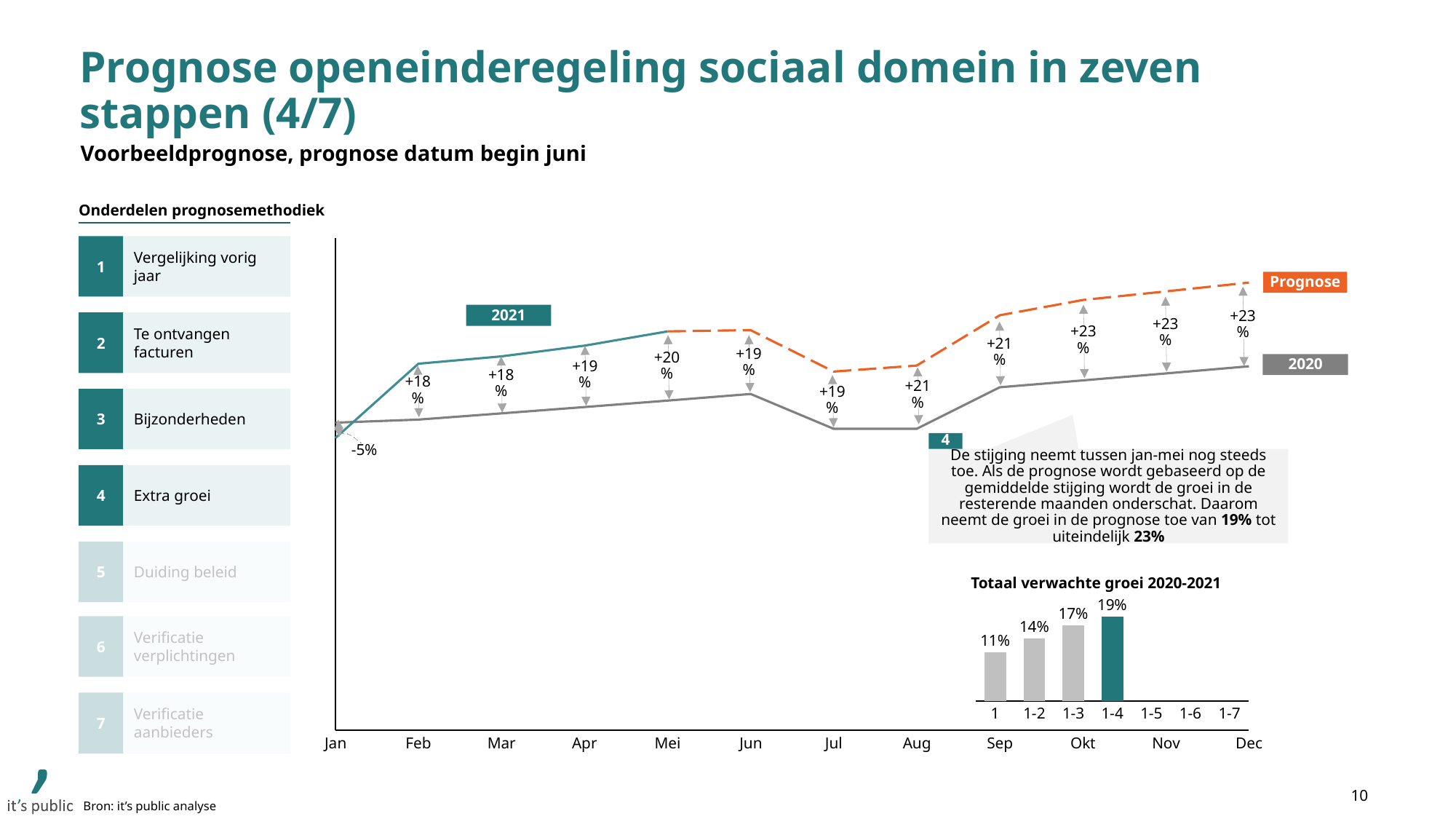
What kind of chart is 'Totaal verwachte groei 2020-2021'? bar chart In the bar chart 'Totaal verwachte groei 2020-2021', which of the plotted bars has the lowest value? 1 In the bar chart 'Totaal verwachte groei 2020-2021', what is the value for category 1? 11% In the large line chart, what percentage is labelled for Jan? -5% In the large line chart, which series is drawn as an orange dashed line? Prognose In the large line chart, what percentage difference is labelled for Mei? +20% In the large line chart, how many months are shown on the x axis? 12 In the bar chart 'Totaal verwachte groei 2020-2021', what is the value for category 1-4? 19% In the bar chart 'Totaal verwachte groei 2020-2021', what is the difference between the values for 1-3 and 1-2? 3% In the bar chart 'Totaal verwachte groei 2020-2021', which category has the highest value? 1-4 In the bar chart 'Totaal verwachte groei 2020-2021', do the values rise or fall from category 1 to category 1-4? rise In the bar chart 'Totaal verwachte groei 2020-2021', what is the difference between the values for 1-4 and 1? 8%